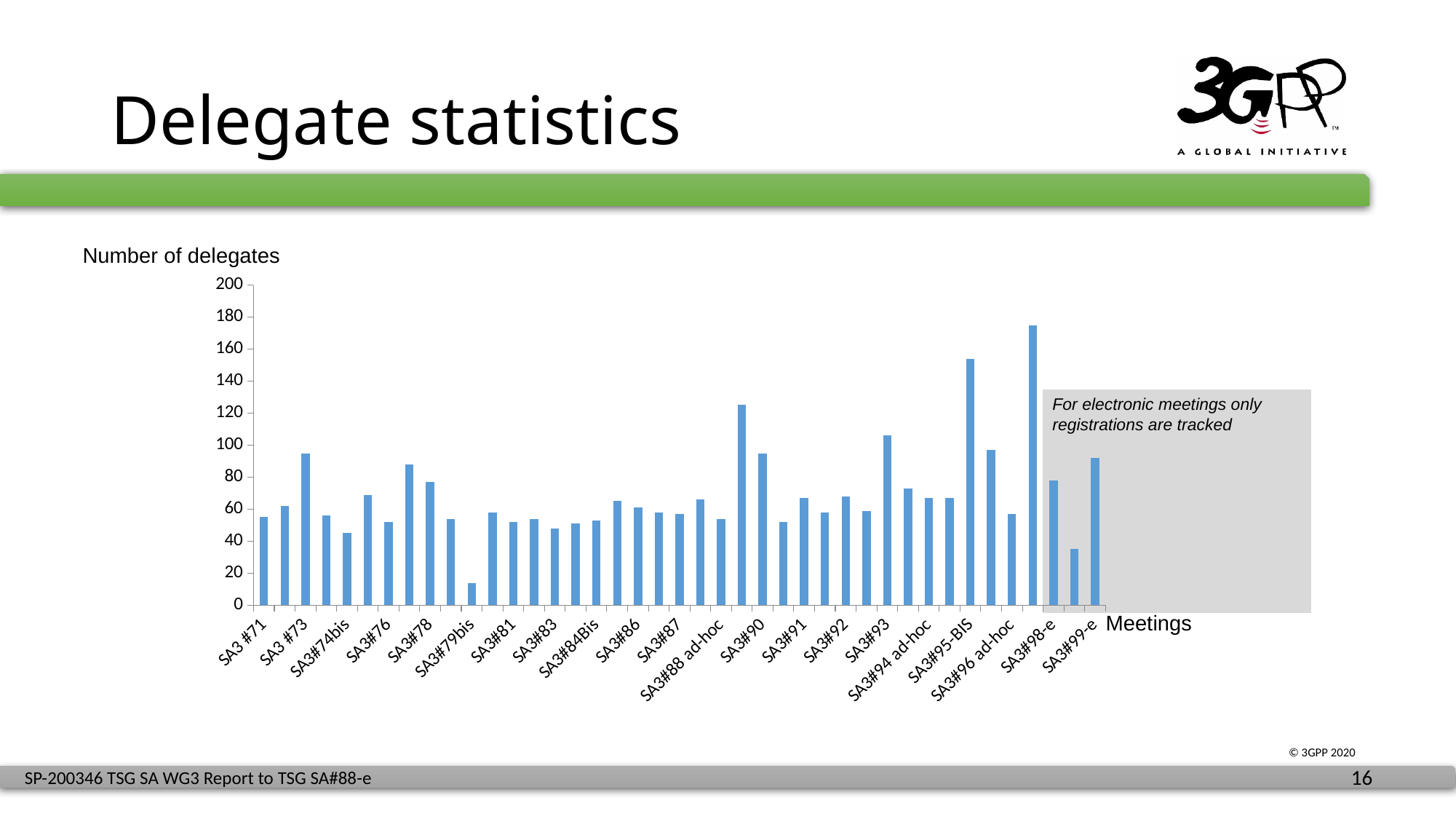
Which labelled meeting has the lowest number of delegates? SA3#79bis Is the number of delegates for SA3#99-e greater or less than 80? greater What kind of chart is shown on the slide? bar chart Is the number of delegates for SA3#98-e greater or less than 60? greater Is the number of delegates for SA3#79bis greater or less than 20? less Which has more delegates, SA3#95-BIS or SA3#93? SA3#95-BIS What note is shown in the shaded box on the right of the chart? For electronic meetings only registrations are tracked What is the label on the vertical axis of the chart? Number of delegates Which has more delegates, SA3 #73 or SA3#74bis? SA3 #73